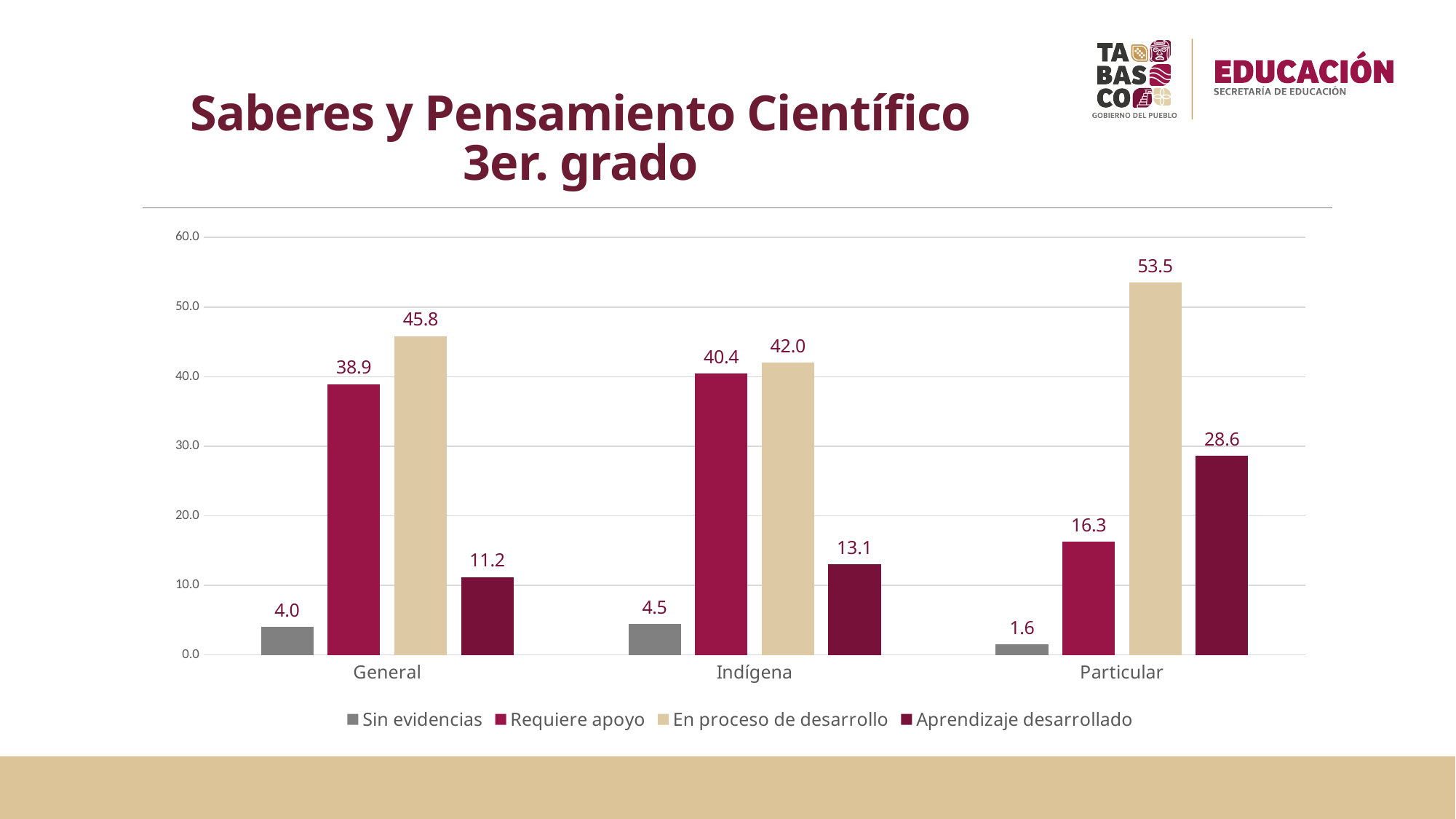
How many categories are shown on the x axis? 3 What is the value of 'Sin evidencias' for General? 4.0 Which category has the lowest value for 'Sin evidencias'? Particular What kind of chart is shown on the slide? Bar chart What is the title of the slide? Saberes y Pensamiento Científico 3er. grado How many series does the legend list? 4 Is the value of 'En proceso de desarrollo' for Particular greater or less than 50.0? greater Which category has the highest value for 'Aprendizaje desarrollado'? Particular What is the value of 'En proceso de desarrollo' for Particular? 53.5 What is the value of 'Requiere apoyo' for Indígena? 40.4 What is the difference between 'En proceso de desarrollo' and 'Requiere apoyo' for General? 6.9 Which is larger for Indígena: 'Requiere apoyo' or 'Aprendizaje desarrollado'? Requiere apoyo